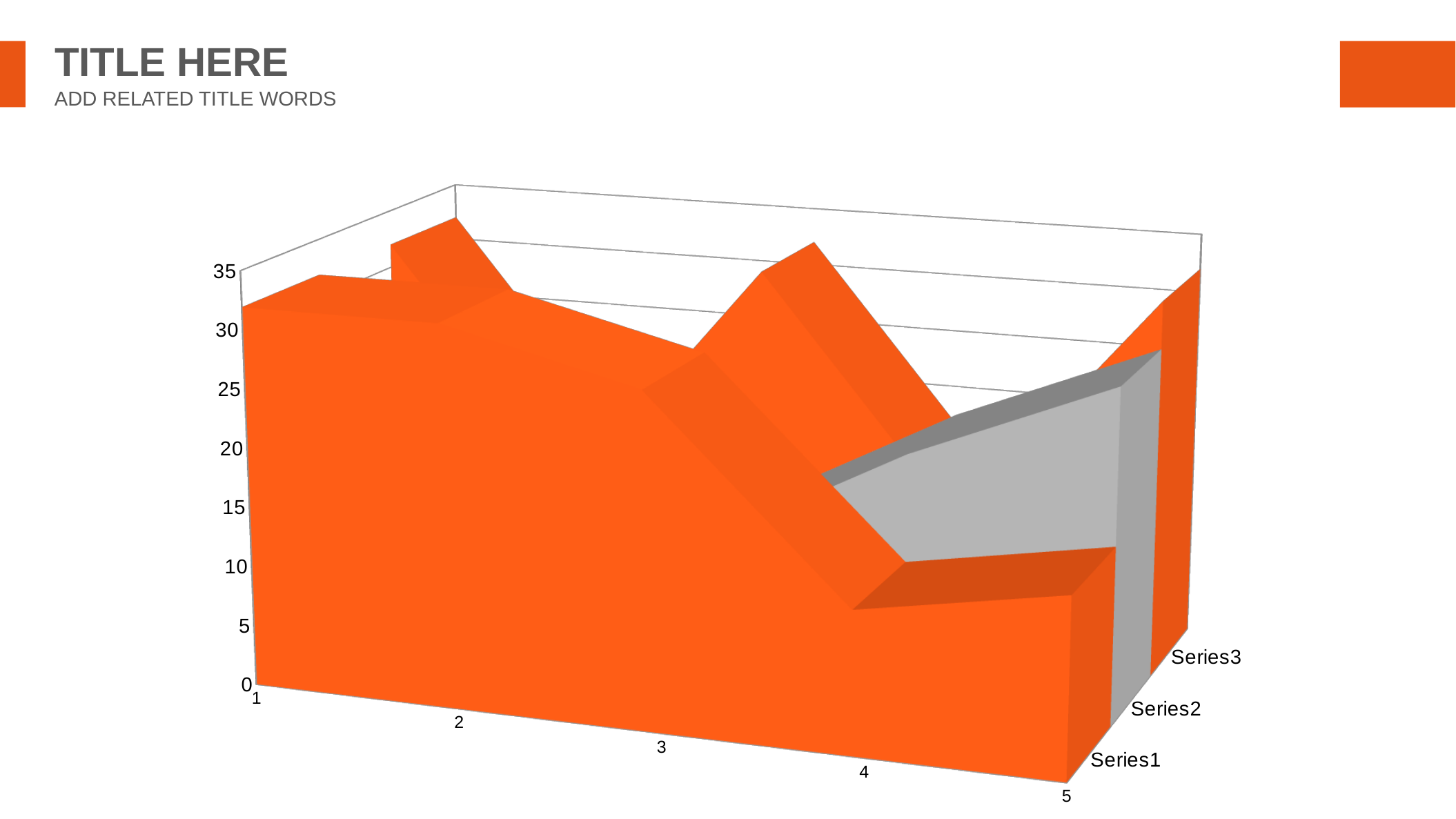
What is the highest value shown on the vertical axis of the chart? 35 Is the value for Series1 at category 5 greater or less than 10? greater How many categories are shown along the x axis of the chart? 5 How many series does the chart show? 3 What are the names of the three series shown on the chart? Series1, Series2, Series3 Does the value for Series1 rise or fall from category 4 to category 5? rise Is the value for Series1 at category 4 greater or less than 25? less Which is larger for Series1: the value at category 1 or the value at category 5? category 1 What is the title shown above the chart on the slide? TITLE HERE Is the value for Series1 at category 1 greater or less than 25? greater What kind of chart is shown on the slide? area chart